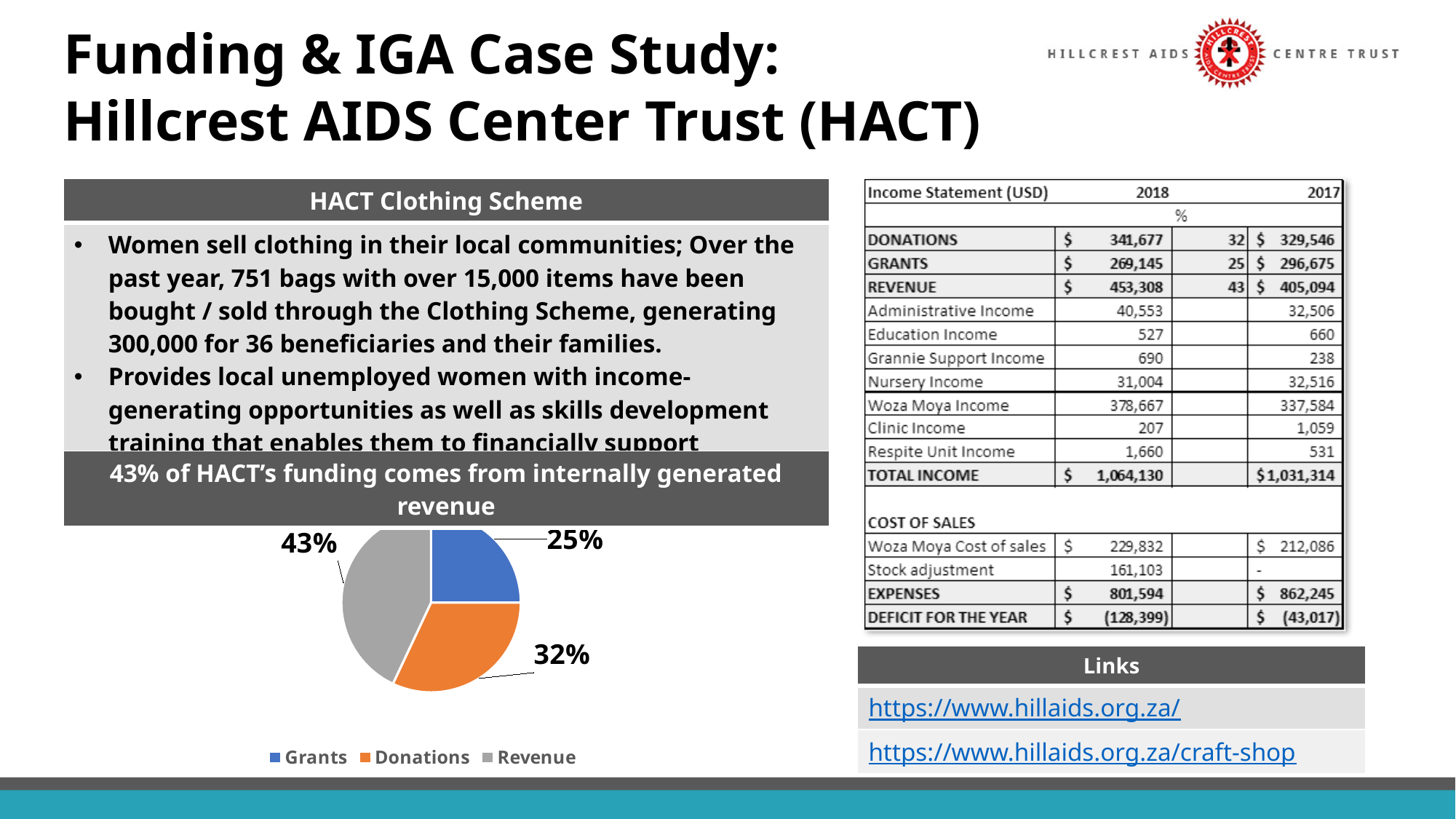
What is the difference in percentage points between the Revenue slice and the Grants slice? 18 How many entries does the pie chart's legend list? 3 How many slices does the pie chart have? 3 Which category has the largest slice in the pie chart? Revenue What share of the pie chart does Grants represent? 25% Which is larger in the pie chart, Donations or Grants? Donations What colour is the Revenue slice in the pie chart? gray Which category has the smallest slice in the pie chart? Grants What colour is the Grants slice in the pie chart? blue What kind of chart is shown on the slide? pie chart What share of the pie chart does Donations represent? 32% What share of the pie chart does Revenue represent? 43%